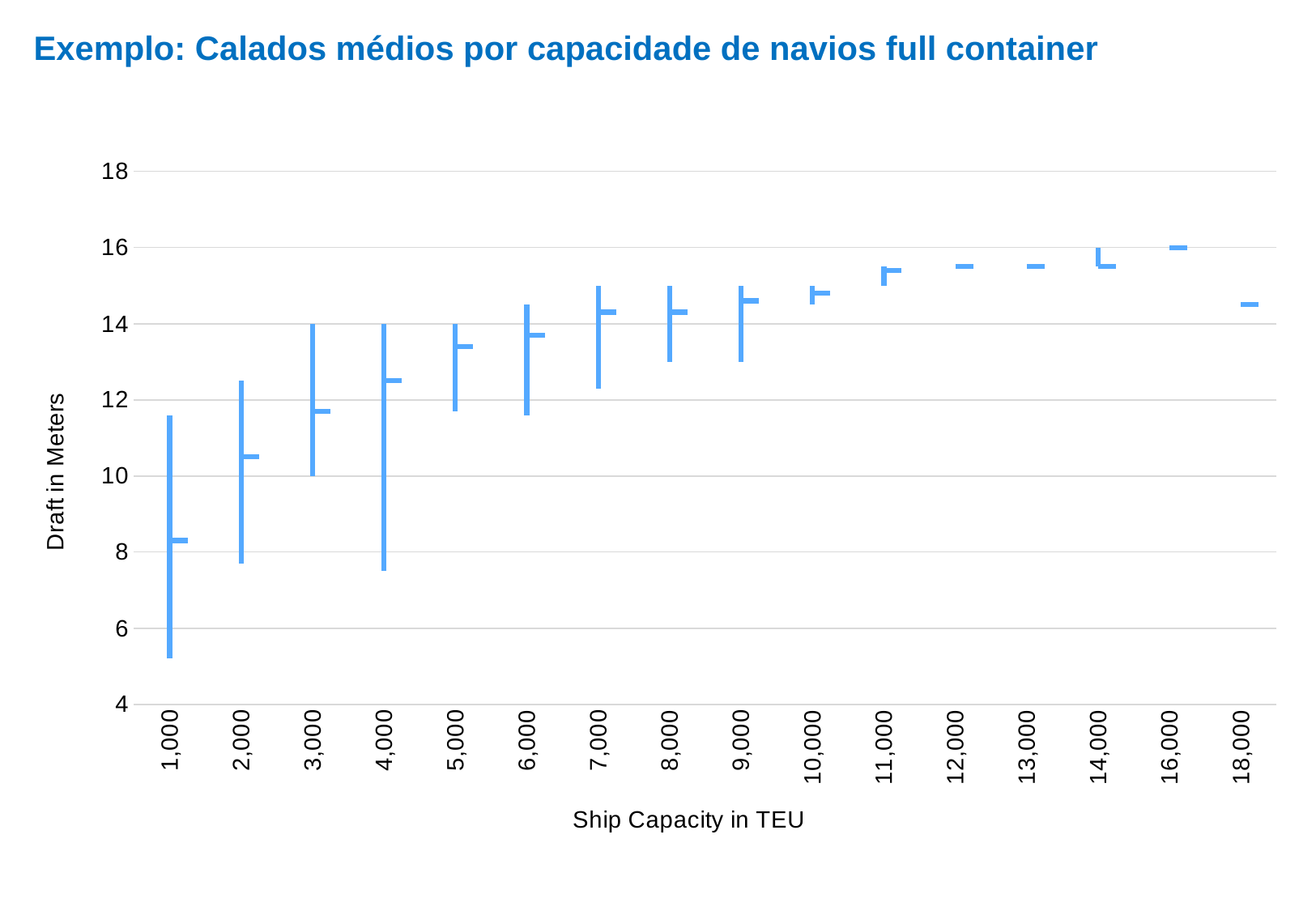
Is the average draft marker for 12,000 TEU greater or less than 14 meters? greater Is the lowest point of the range for 1,000 TEU greater or less than 6 meters? less Is the average draft marker for 1,000 TEU greater or less than 10 meters? less What is the title of the chart? Exemplo: Calados médios por capacidade de navios full container Do the average draft markers generally rise or fall as ship capacity increases from 1,000 to 16,000 TEU? rise Which ship capacity has the lowest average draft marker? 1,000 Which ship capacity has the highest average draft marker? 16,000 Which has the larger average draft marker, 2,000 TEU or 3,000 TEU? 3,000 TEU How many ship capacity categories are shown on the x axis? 16 What is the label of the vertical axis? Draft in Meters